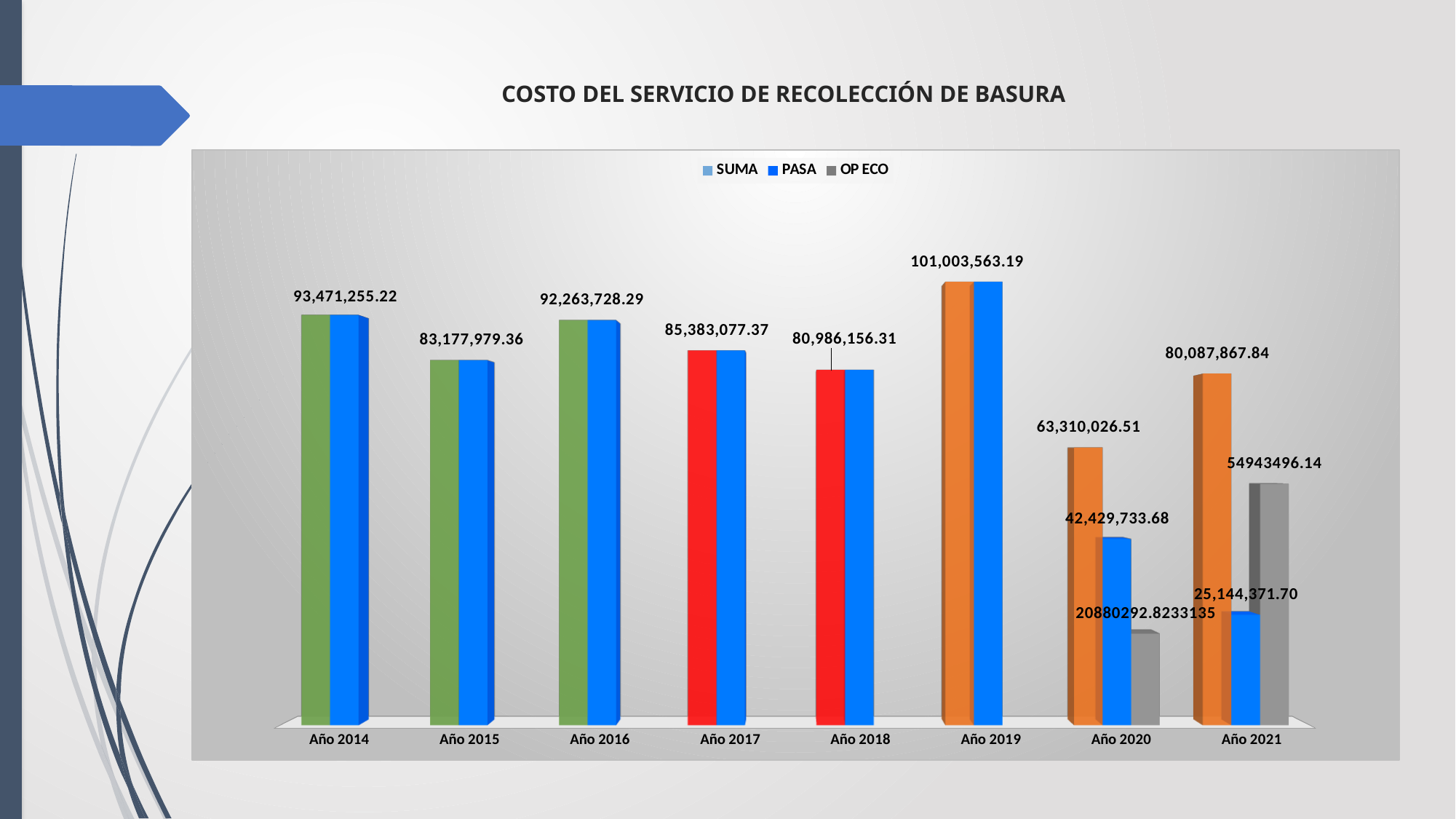
What is the SUMA value for Año 2021? 80,087,867.84 In Año 2021, which is larger, PASA or OP ECO? OP ECO How many series does the legend list? 3 What kind of chart is shown on the slide? bar chart What is the difference between the SUMA values for Año 2014 and Año 2015? 10,293,275.86 What is the OP ECO value for Año 2021? 54943496.14 How many years are shown on the x axis? 8 What is the SUMA value for Año 2019? 101,003,563.19 What is the title of the chart? COSTO DEL SERVICIO DE RECOLECCIÓN DE BASURA Which year has the highest SUMA value? Año 2019 What is the PASA value for Año 2020? 42,429,733.68 Which year has the lowest SUMA value? Año 2020